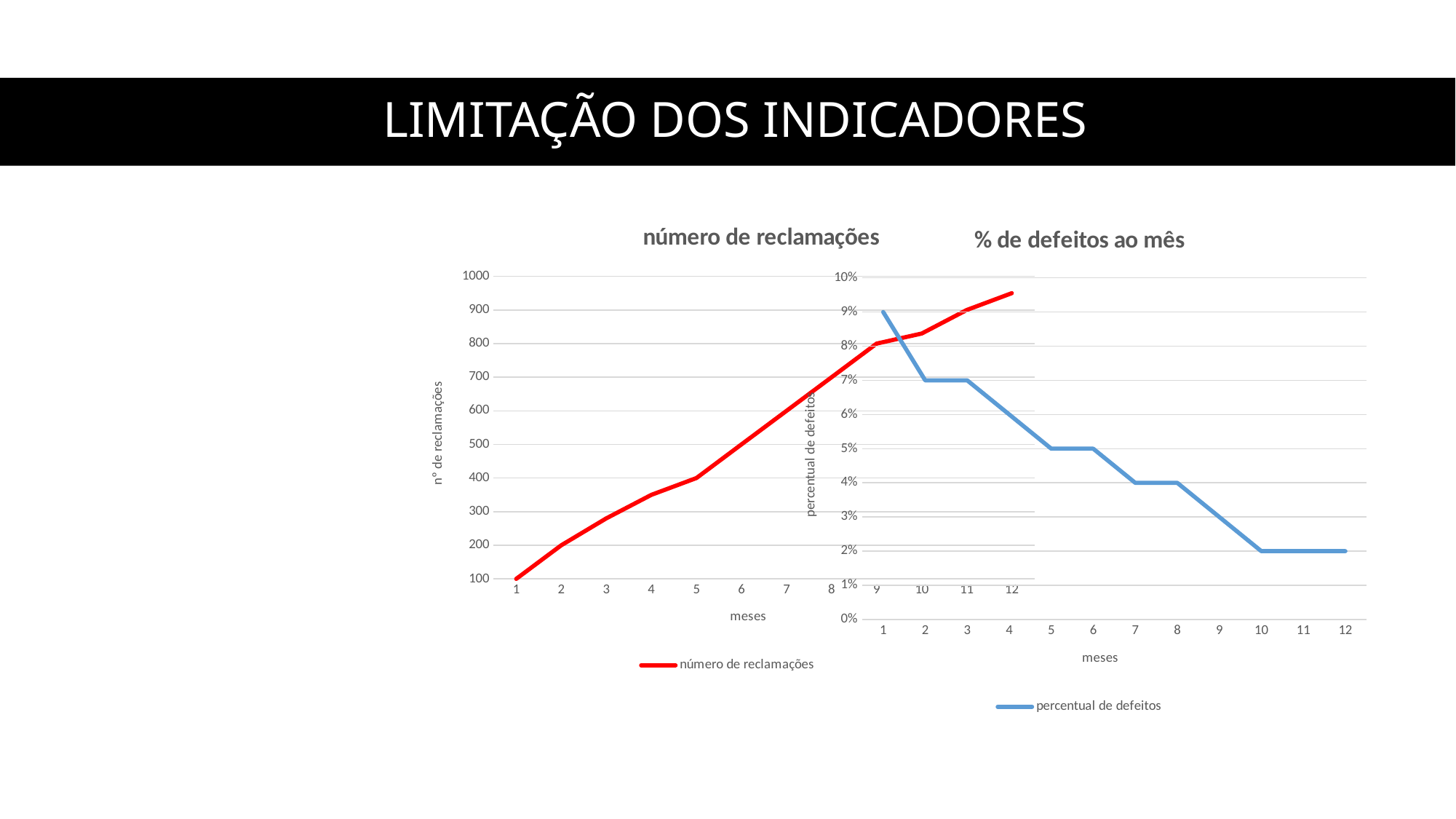
In the "número de reclamações" chart, is the value for month 3 greater or less than 400? less In the "% de defeitos ao mês" chart, what is the value for month 12? 2% How many months are shown on the x axis of the "% de defeitos ao mês" chart? 12 What kind of chart is the "número de reclamações" chart? line chart How many series does the legend of the "número de reclamações" chart list? 1 In the "% de defeitos ao mês" chart, do the values rise or fall from month 1 to month 12? fall What kind of chart is the "% de defeitos ao mês" chart? line chart In the "% de defeitos ao mês" chart, what is the value for month 1? 9% In the "número de reclamações" chart, do the values rise or fall from month 1 to month 12? rise In the "% de defeitos ao mês" chart, which month has the highest value? 1 In the "número de reclamações" chart, is the value for month 12 greater or less than 900? greater What is the legend entry of the "% de defeitos ao mês" chart? percentual de defeitos